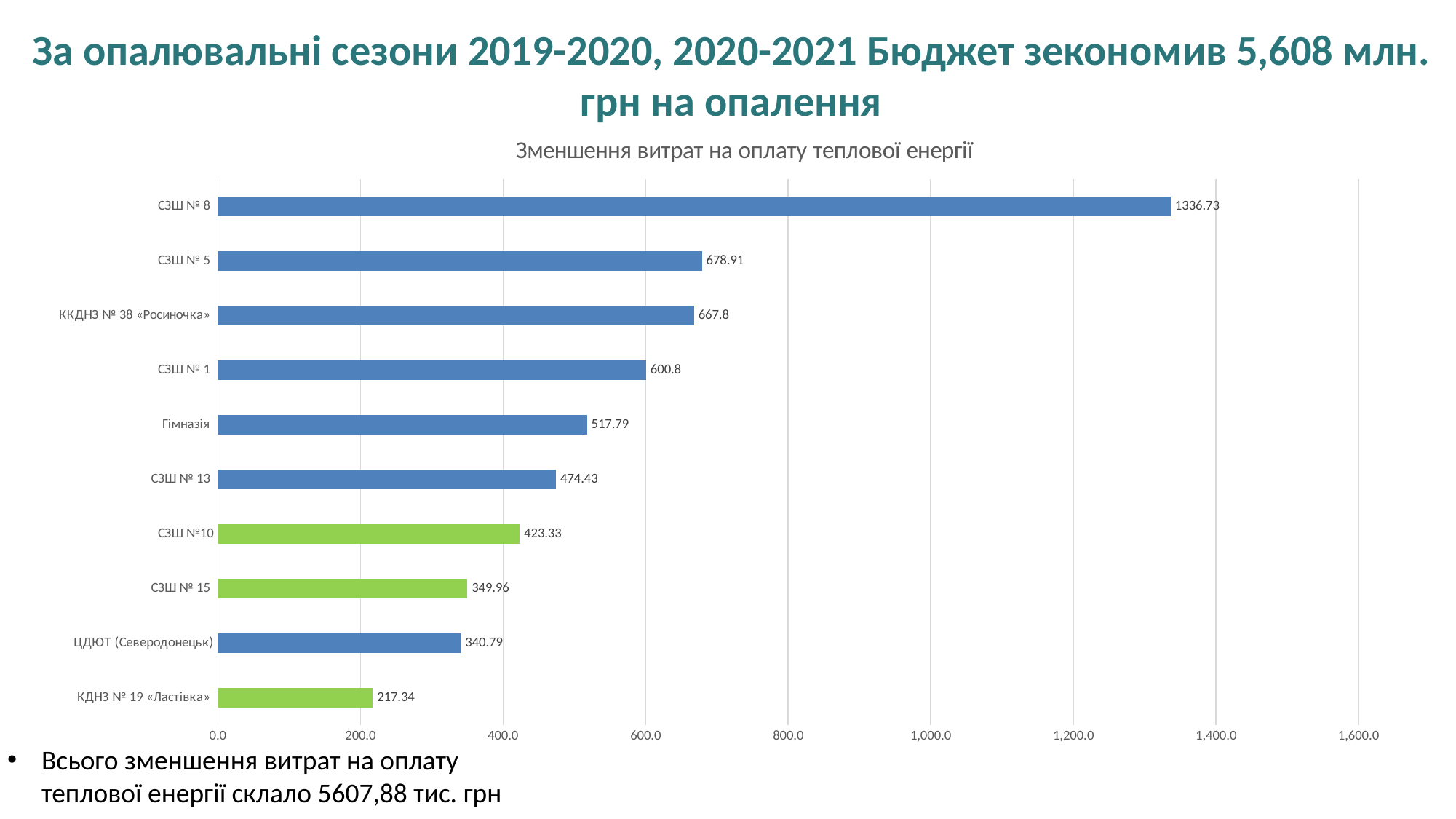
What kind of chart is shown on the slide? bar chart What is the value for ЦДЮТ (Северодонецьк)? 340.79 What is the title of the chart? Зменшення витрат на оплату теплової енергії Which category has the highest value? СЗШ № 8 What is the value for Гімназія? 517.79 What is the value for СЗШ № 8? 1336.73 Which category has the lowest value? КДНЗ № 19 «Ластівка» What is the difference between the values for СЗШ №10 and СЗШ № 15? 73.37 Which is larger, the value for Гімназія or the value for СЗШ № 13? Гімназія What is the difference between the values for СЗШ № 8 and СЗШ № 5? 657.82 How many categories are shown in the chart? 10 Is the value for ЦДЮТ (Северодонецьк) greater or less than 400.0? less